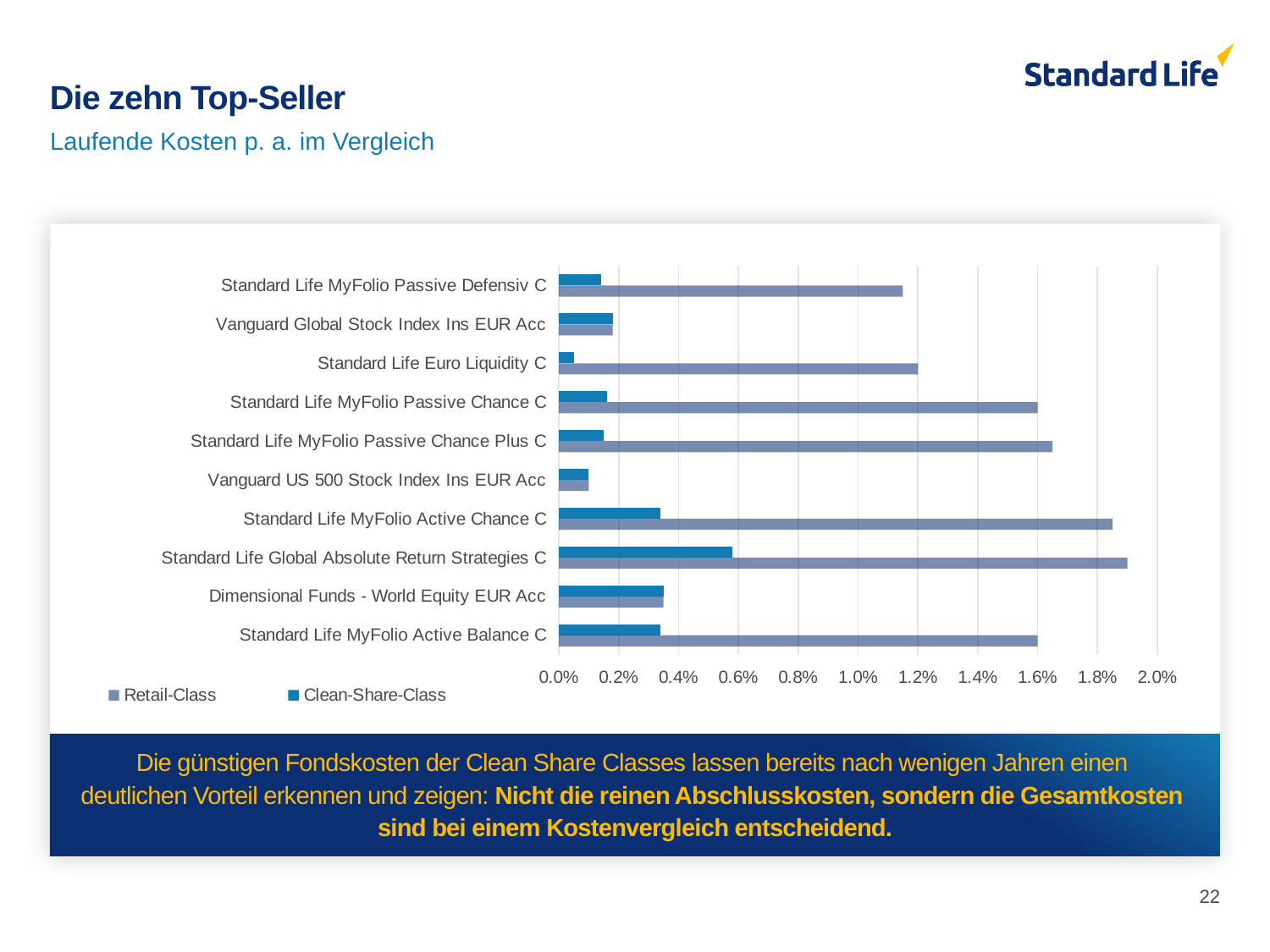
For Standard Life MyFolio Active Balance C, which is larger: the Retail-Class value or the Clean-Share-Class value? Retail-Class Which is larger: the Clean-Share-Class value for Standard Life Global Absolute Return Strategies C or for Standard Life MyFolio Active Chance C? Standard Life Global Absolute Return Strategies C Which fund has the highest Retail-Class value? Standard Life Global Absolute Return Strategies C How many funds (categories) are listed on the chart? 10 Which fund has the lowest Clean-Share-Class value? Standard Life Euro Liquidity C Is the Retail-Class value for Standard Life MyFolio Passive Defensiv C greater or less than 1.0%? greater Is the Clean-Share-Class value for Standard Life Euro Liquidity C greater or less than 0.2%? less Which fund has the highest Clean-Share-Class value? Standard Life Global Absolute Return Strategies C What are the two series named in the chart legend? Retail-Class and Clean-Share-Class Is the Clean-Share-Class value for Standard Life Global Absolute Return Strategies C greater or less than 0.4%? greater What kind of chart is shown on the slide? bar chart How many series does the chart legend list? 2